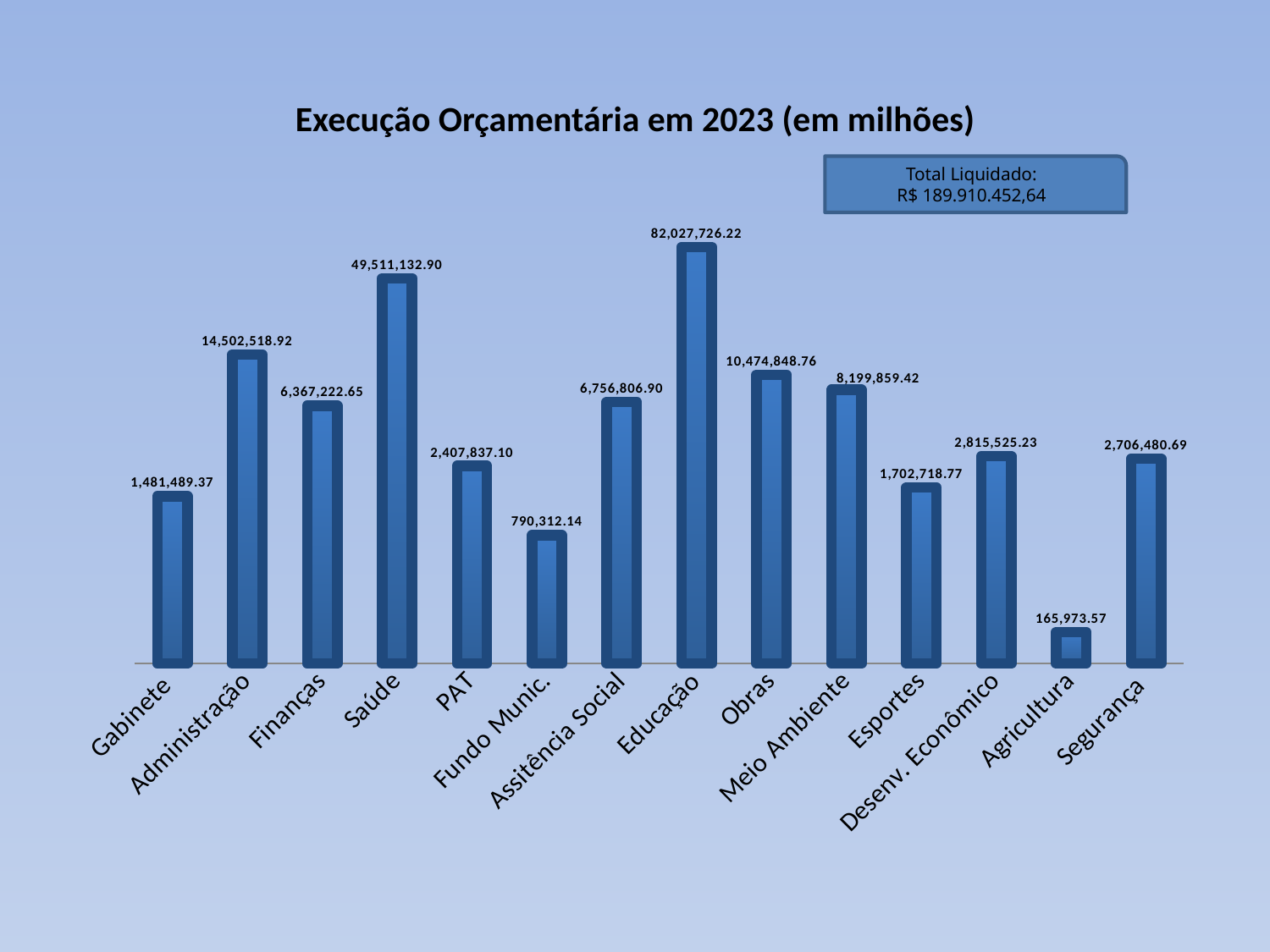
What is the value for Educação? 82,027,726.22 What is the value for Meio Ambiente? 8,199,859.42 What is the difference between the values for Educação and Saúde? 32,516,593.32 What is the value for Fundo Munic.? 790,312.14 What kind of chart is shown on the slide? Bar chart How many categories are shown on the x axis? 14 Which is larger, the value for Administração or the value for Obras? Administração Which category has the lowest value? Agricultura What is the value for Saúde? 49,511,132.90 What is the difference between the values for Obras and Meio Ambiente? 2,274,989.34 Which category has the highest value? Educação What is the title of the chart? Execução Orçamentária em 2023 (em milhões)